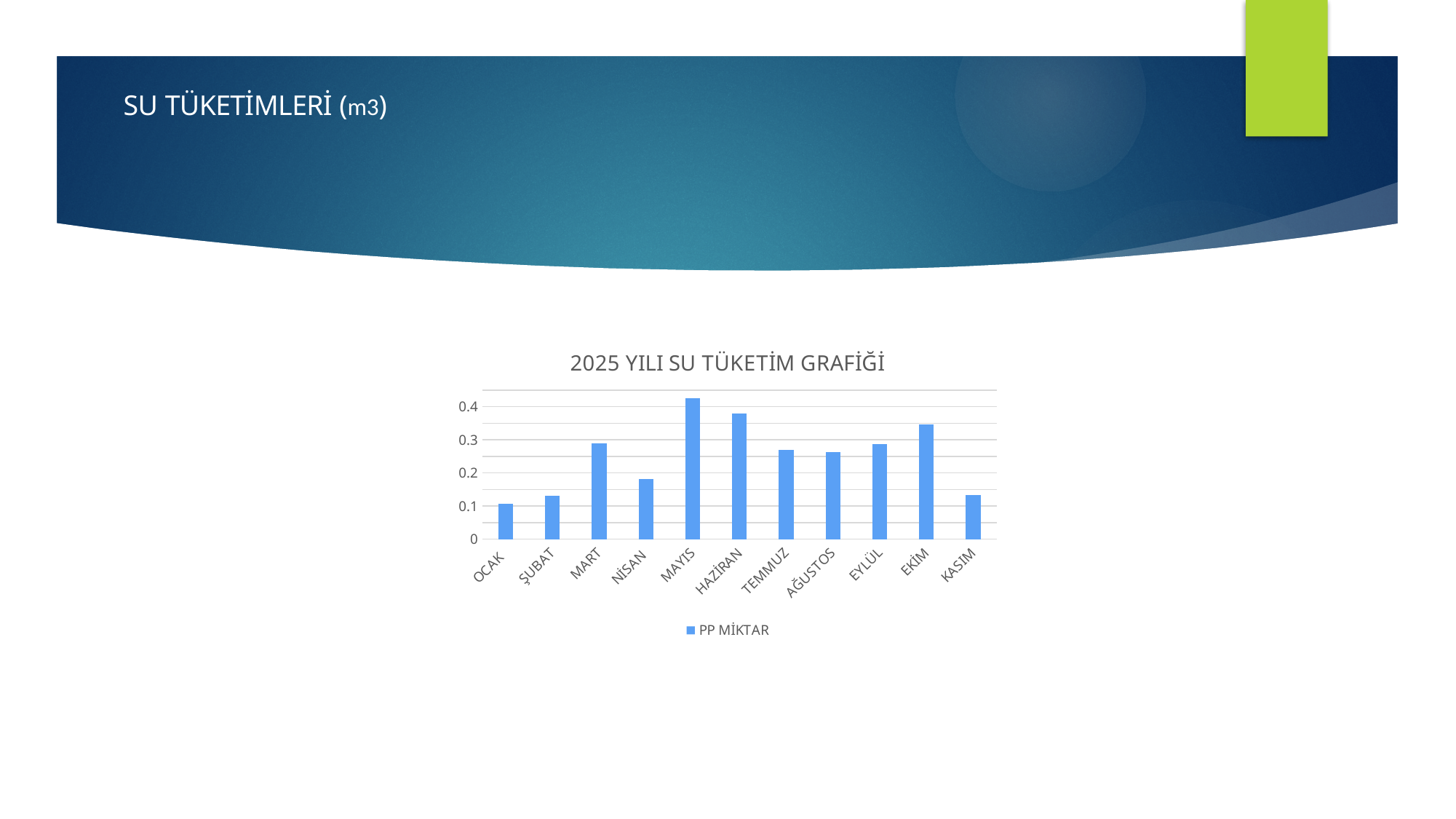
Is the value for NİSAN greater or less than 0.2? less What is the name of the series shown in the legend? PP MİKTAR Is the value for KASIM greater or less than 0.1? greater How many months (categories) are shown on the x axis? 11 Is the value for HAZİRAN greater or less than 0.3? greater How many series does the legend list? 1 What kind of chart is shown on the slide? bar chart Do the values rise or fall from OCAK to MAYIS? rise What is the title of the chart? 2025 YILI SU TÜKETİM GRAFİĞİ Which is larger, the value for EKİM or the value for EYLÜL? EKİM Which month has the highest value? MAYIS